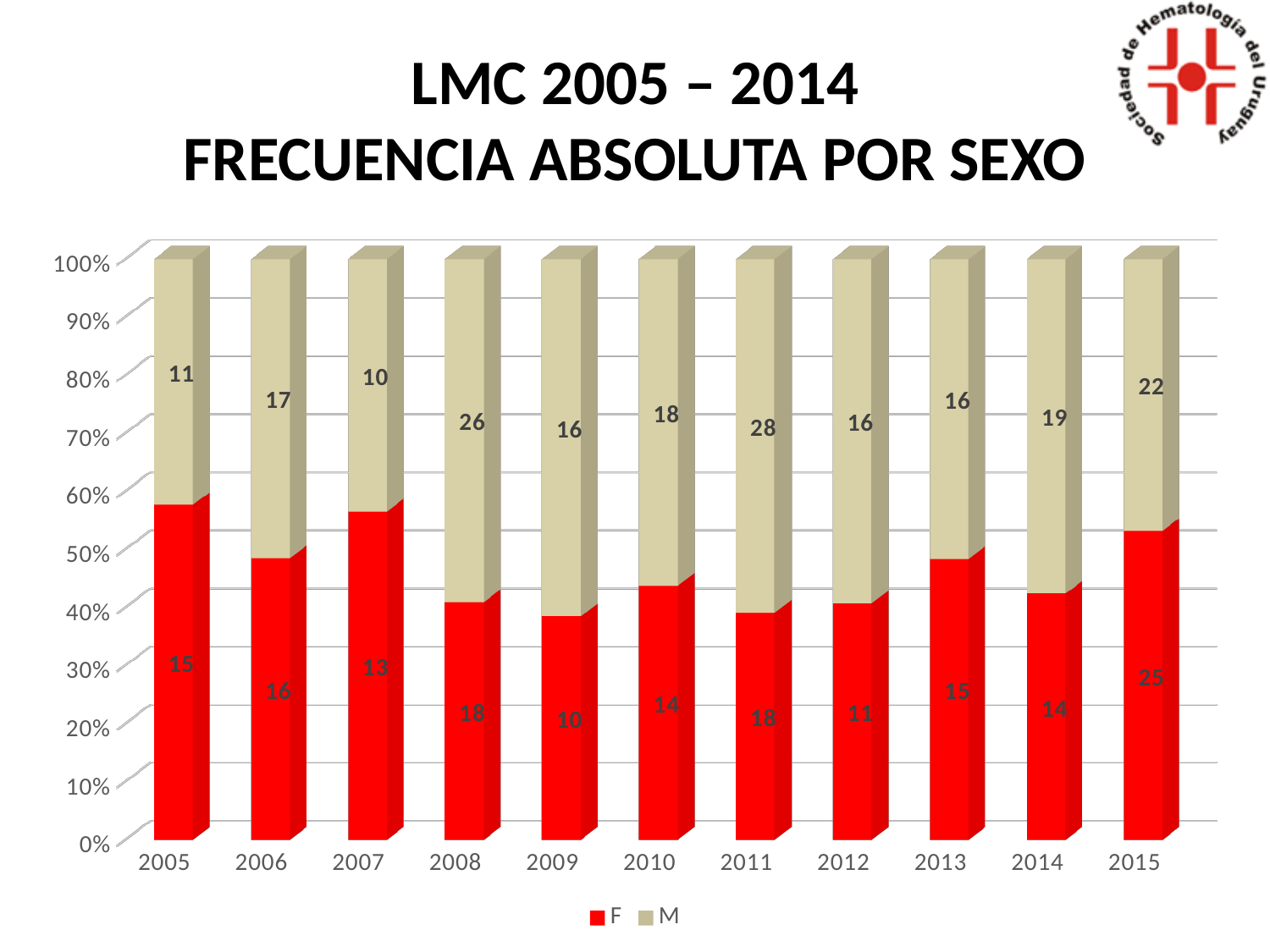
How many series does the legend list? 2 What is the value for M in 2008? 26 Which year has the lowest value for F? 2009 What is the total of the F and M values for 2015? 47 Which year has the highest value for M? 2011 How many years are shown on the x axis? 11 Is the F share of the 2005 bar greater or less than 50%? greater What is the value for F in 2009? 10 What is the difference between the M and F values in 2011? 10 What kind of chart is shown on the slide? Stacked bar chart In 2008, which is larger, the value for F or the value for M? M What is the value for F in 2015? 25